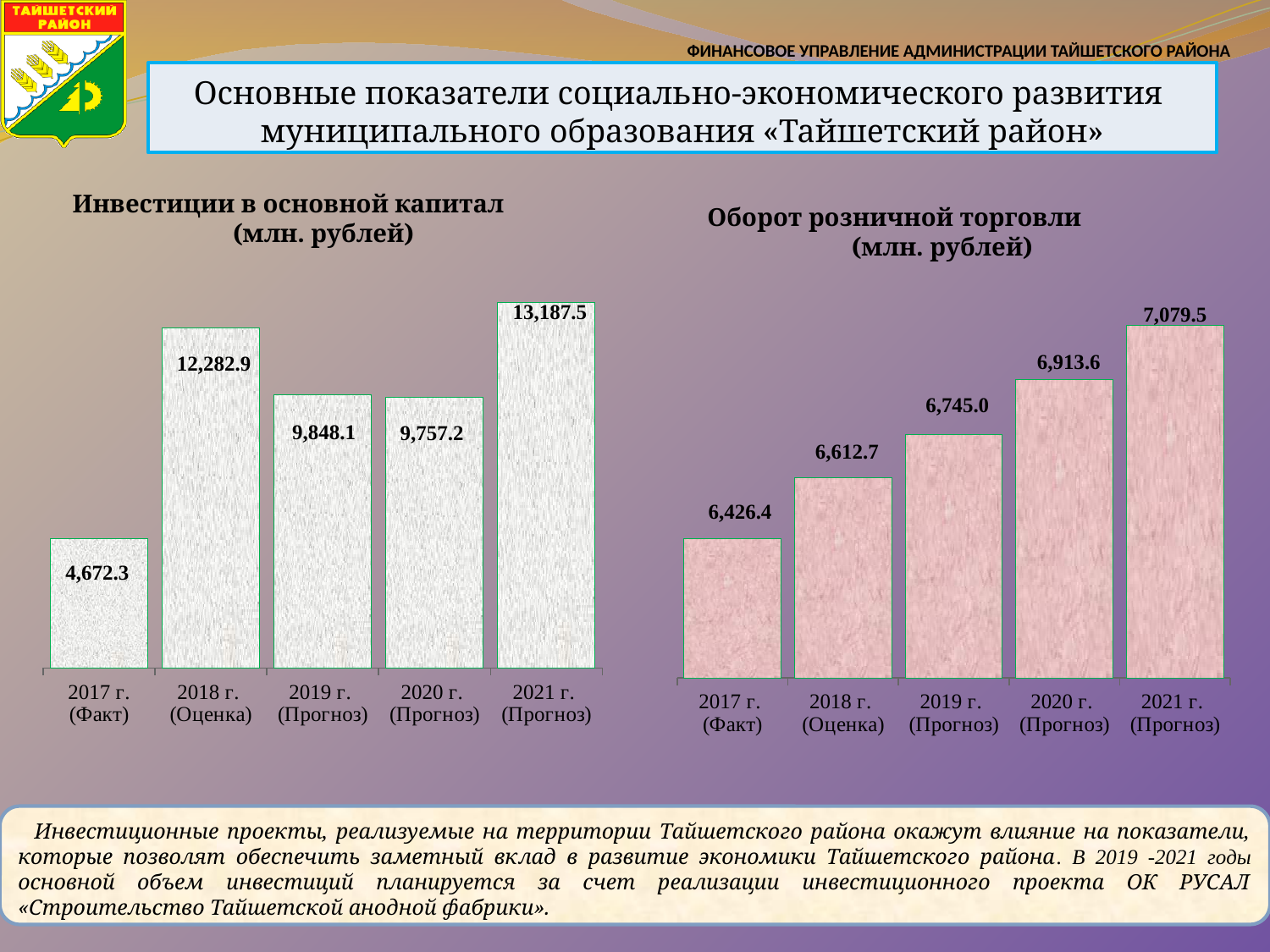
In the chart 'Инвестиции в основной капитал (млн. рублей)', what is the difference between the values for 2021 г. (Прогноз) and 2018 г. (Оценка)? 904.6 In the chart 'Инвестиции в основной капитал (млн. рублей)', which year has the highest value? 2021 г. (Прогноз) What type of chart is 'Инвестиции в основной капитал (млн. рублей)'? bar chart In the chart 'Инвестиции в основной капитал (млн. рублей)', which is larger: the value for 2019 г. (Прогноз) or 2020 г. (Прогноз)? 2019 г. (Прогноз) How many categories (years) are shown in the chart 'Оборот розничной торговли (млн. рублей)'? 5 In the chart 'Инвестиции в основной капитал (млн. рублей)', which year has the lowest value? 2017 г. (Факт) In the chart 'Оборот розничной торговли (млн. рублей)', what is the value for 2021 г. (Прогноз)? 7,079.5 In the chart 'Инвестиции в основной капитал (млн. рублей)', what is the value for 2020 г. (Прогноз)? 9,757.2 In the chart 'Оборот розничной торговли (млн. рублей)', what is the value for 2019 г. (Прогноз)? 6,745.0 In the chart 'Оборот розничной торговли (млн. рублей)', what is the difference between the values for 2021 г. (Прогноз) and 2017 г. (Факт)? 653.1 In the chart 'Инвестиции в основной капитал (млн. рублей)', what is the value for 2017 г. (Факт)? 4,672.3 In the chart 'Оборот розничной торговли (млн. рублей)', do the values rise or fall from 2017 to 2021? rise